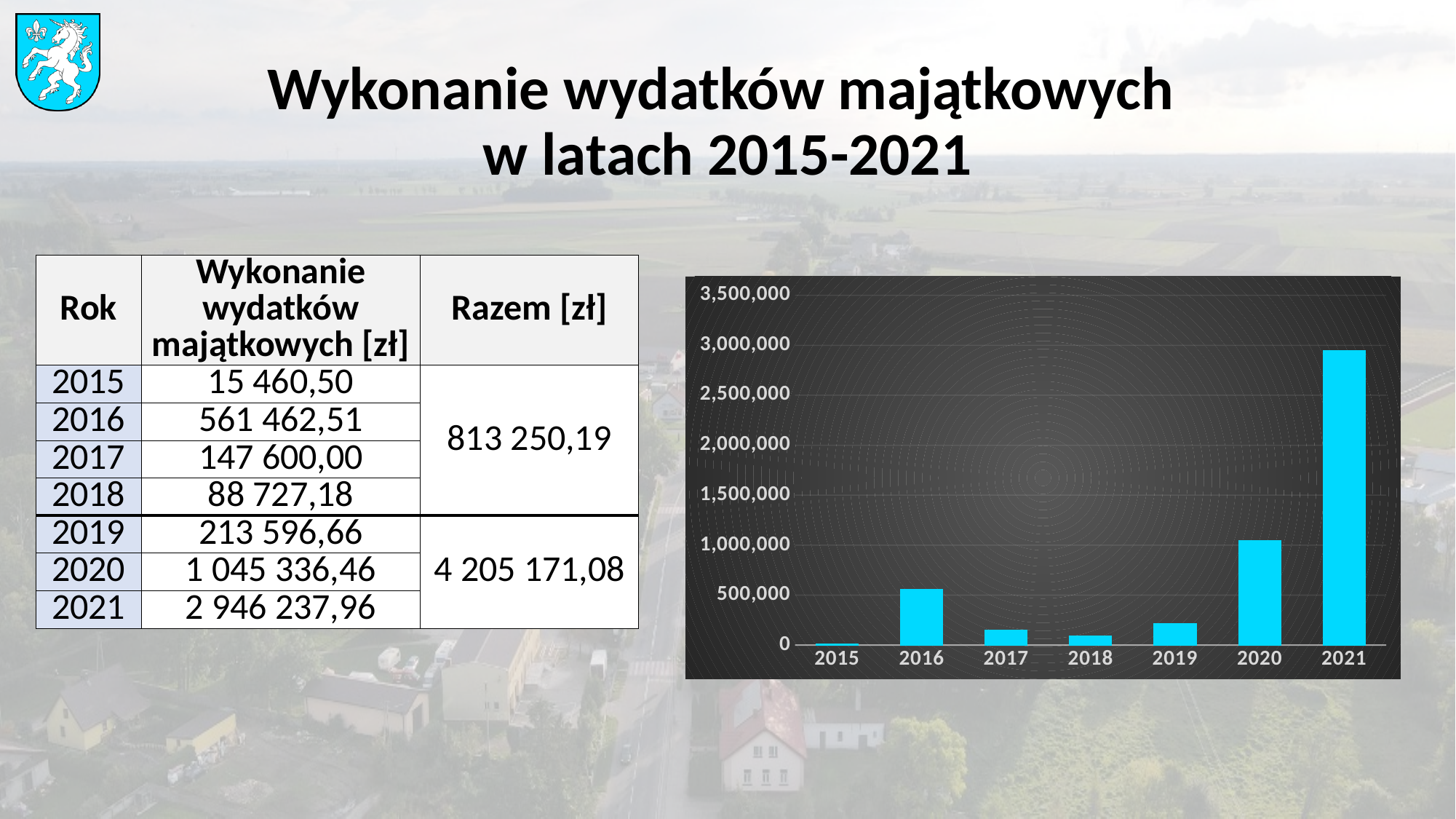
Do the bar values rise or fall from 2018 to 2021? rise Which year has the highest bar in the chart? 2021 In the chart, is the value for 2019 greater or less than 500,000? less How many years (bars) are plotted in the chart? 7 In the chart, is the value for 2017 greater or less than 500,000? less In the chart, which bar is taller, 2016 or 2017? 2016 In the chart, is the value for 2016 greater or less than 500,000? greater Which year has the lowest bar in the chart? 2015 In the chart, which bar is taller, 2020 or 2021? 2021 According to the table on the slide, what is the value of capital expenditure (wydatki majątkowe) for 2021? 2 946 237,96 What kind of chart is shown on the slide? bar chart What is the highest value shown on the chart's vertical axis? 3,500,000